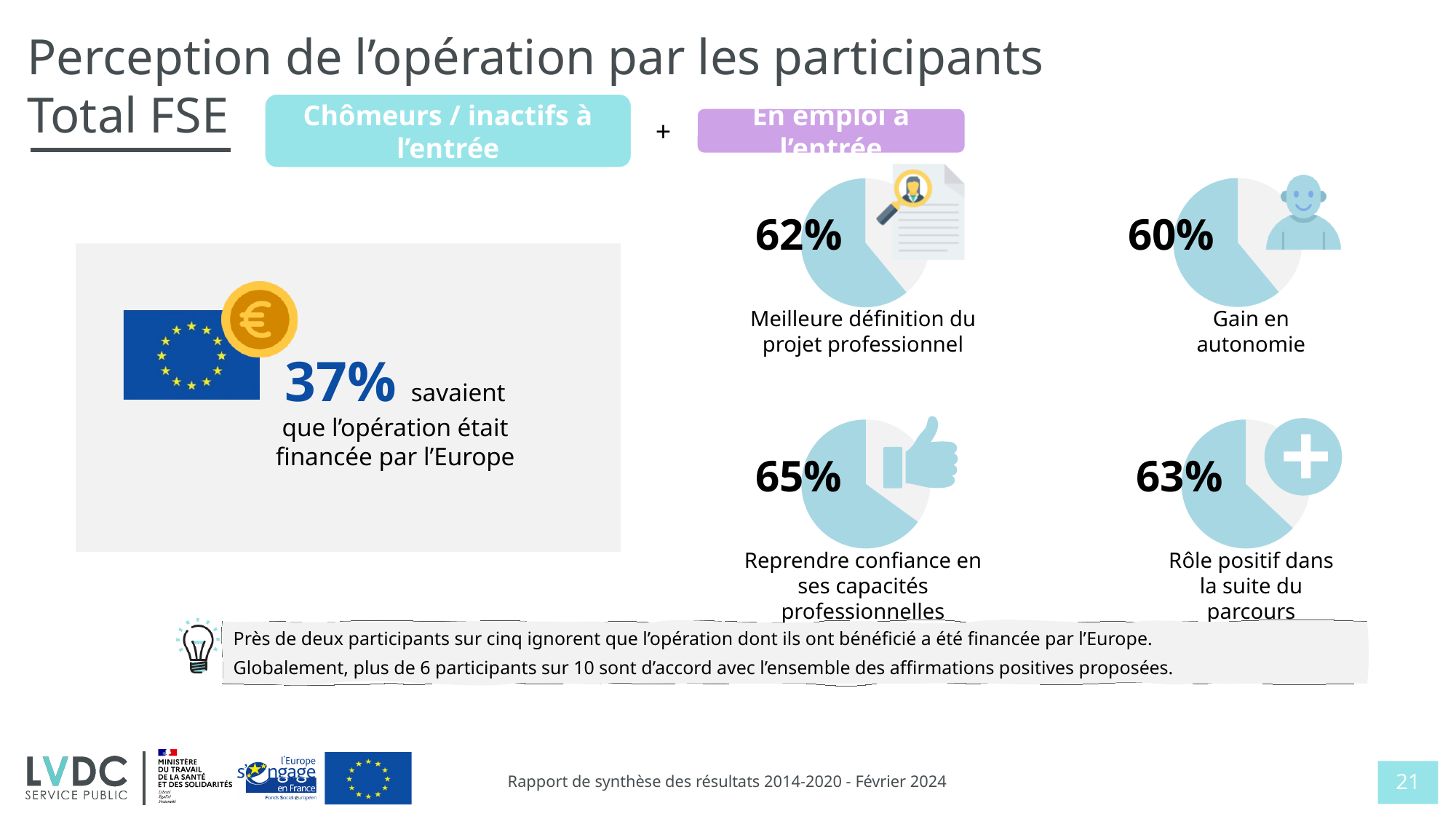
What percentage is shown on the pie chart labelled "Reprendre confiance en ses capacités professionnelles"? 65% What is the difference between the percentage for "Rôle positif dans la suite du parcours" and the percentage for "Meilleure définition du projet professionnel"? 1% What percentage is shown on the pie chart labelled "Meilleure définition du projet professionnel"? 62% How many pie charts are shown on the right side of the slide? 4 Among the four pie charts on the right of the slide, which statement has the lowest percentage? Gain en autonomie What percentage is shown on the pie chart labelled "Gain en autonomie"? 60% Which is larger: the percentage for "Rôle positif dans la suite du parcours" or the percentage for "Meilleure définition du projet professionnel"? Rôle positif dans la suite du parcours What percentage of participants knew that the operation was financed by Europe, according to the grey box on the left? 37% What percentage is shown on the pie chart labelled "Rôle positif dans la suite du parcours"? 63% What kind of chart is used to show the percentage for "Gain en autonomie"? Pie chart Among the four pie charts on the right of the slide, which statement has the highest percentage? Reprendre confiance en ses capacités professionnelles What is the difference between the percentage for "Reprendre confiance en ses capacités professionnelles" and the percentage for "Gain en autonomie"? 5%